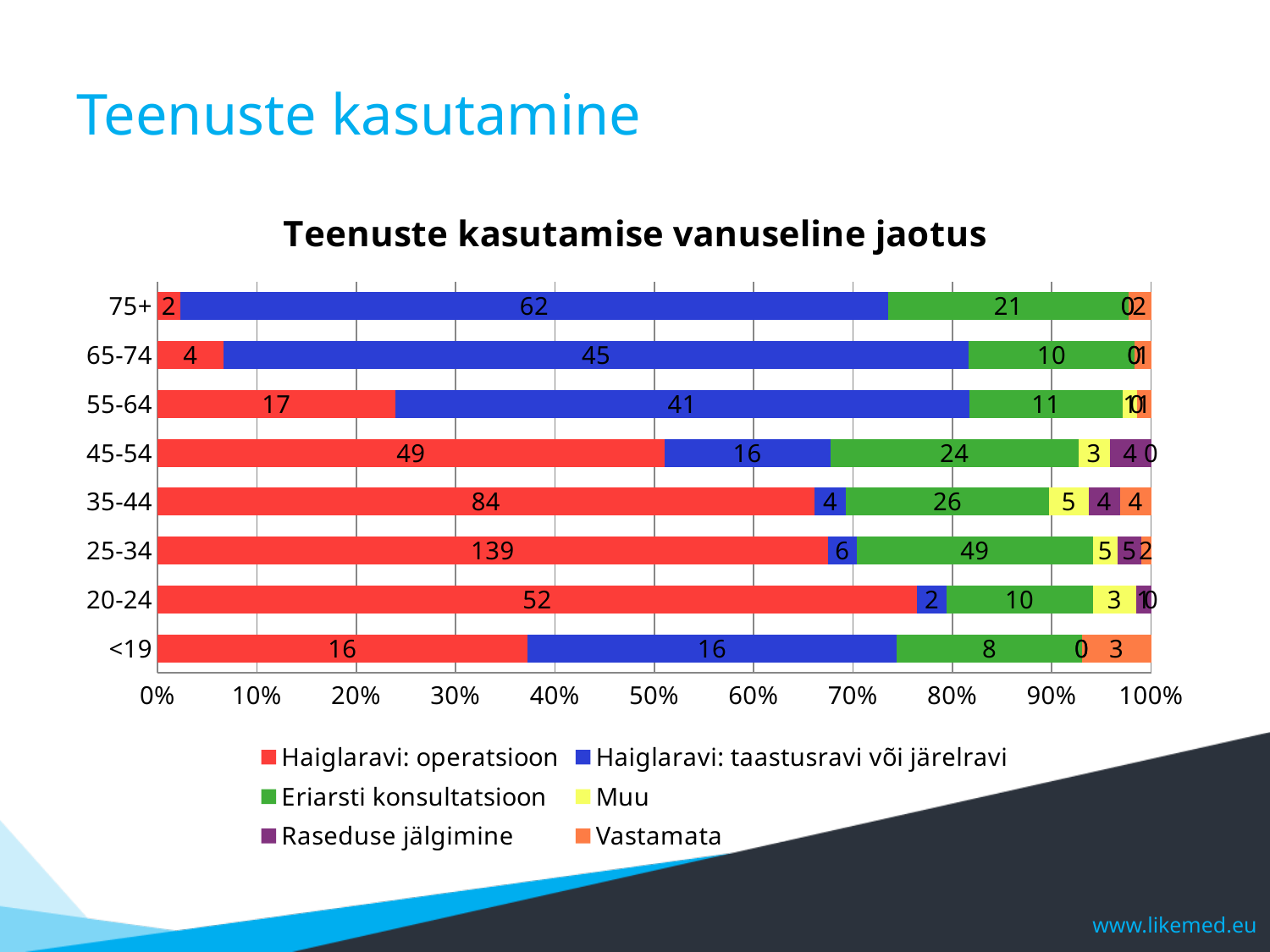
What is the value for 'Haiglaravi: operatsioon' in the 25-34 age group? 139 What is the value for 'Haiglaravi: taastusravi või järelravi' in the 75+ age group? 62 Is the share of 'Haiglaravi: operatsioon' in the 25-34 age group greater or less than 60%? greater What type of chart is shown on the slide? Stacked bar chart What is the difference between 'Haiglaravi: operatsioon' and 'Eriarsti konsultatsioon' in the 35-44 age group? 58 What is the total of all values in the 45-54 age group bar? 96 What is the value for 'Eriarsti konsultatsioon' in the 35-44 age group? 26 In the 45-54 age group, which is larger: 'Haiglaravi: operatsioon' or 'Eriarsti konsultatsioon'? Haiglaravi: operatsioon How many series does the legend list? 6 How many age groups are shown on the chart? 8 What is the title of the chart? Teenuste kasutamise vanuseline jaotus Which age group has the highest value for 'Haiglaravi: operatsioon'? 25-34